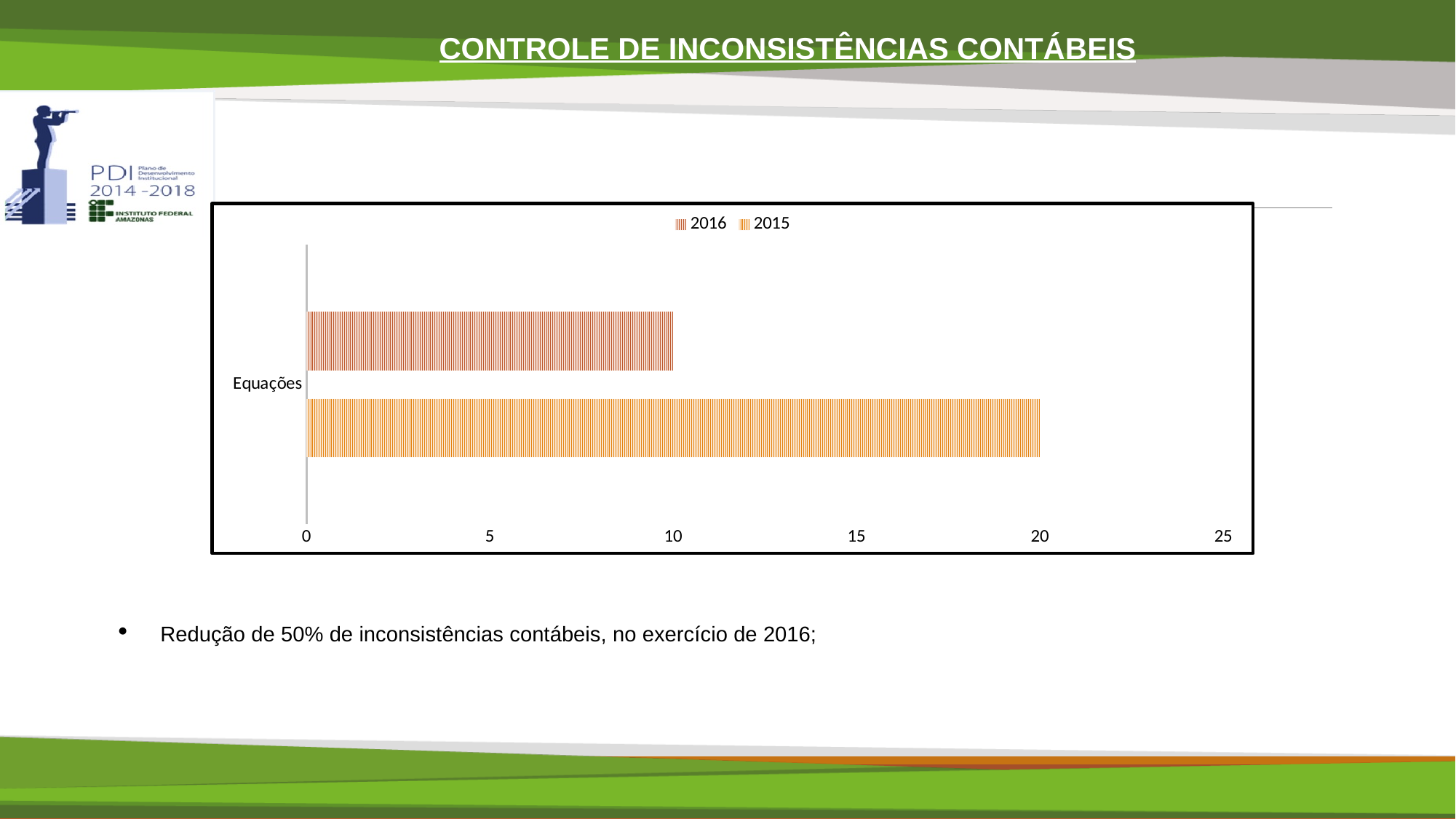
Is the value for 2015 for Equações greater or less than 15? greater What is the name of the category shown on the vertical axis? Equações What is the difference between the 2015 and 2016 values for Equações? 10 Which series are listed in the legend? 2016 and 2015 Which series has the lowest value for Equações? 2016 What kind of chart is shown on the slide? bar chart Is the value for 2016 for Equações greater or less than 15? less What is the value for 2016 for Equações? 10 Which series has the larger value for Equações, 2016 or 2015? 2015 How many series does the legend list? 2 How many categories are plotted on the chart? 1 What is the value for 2015 for Equações? 20